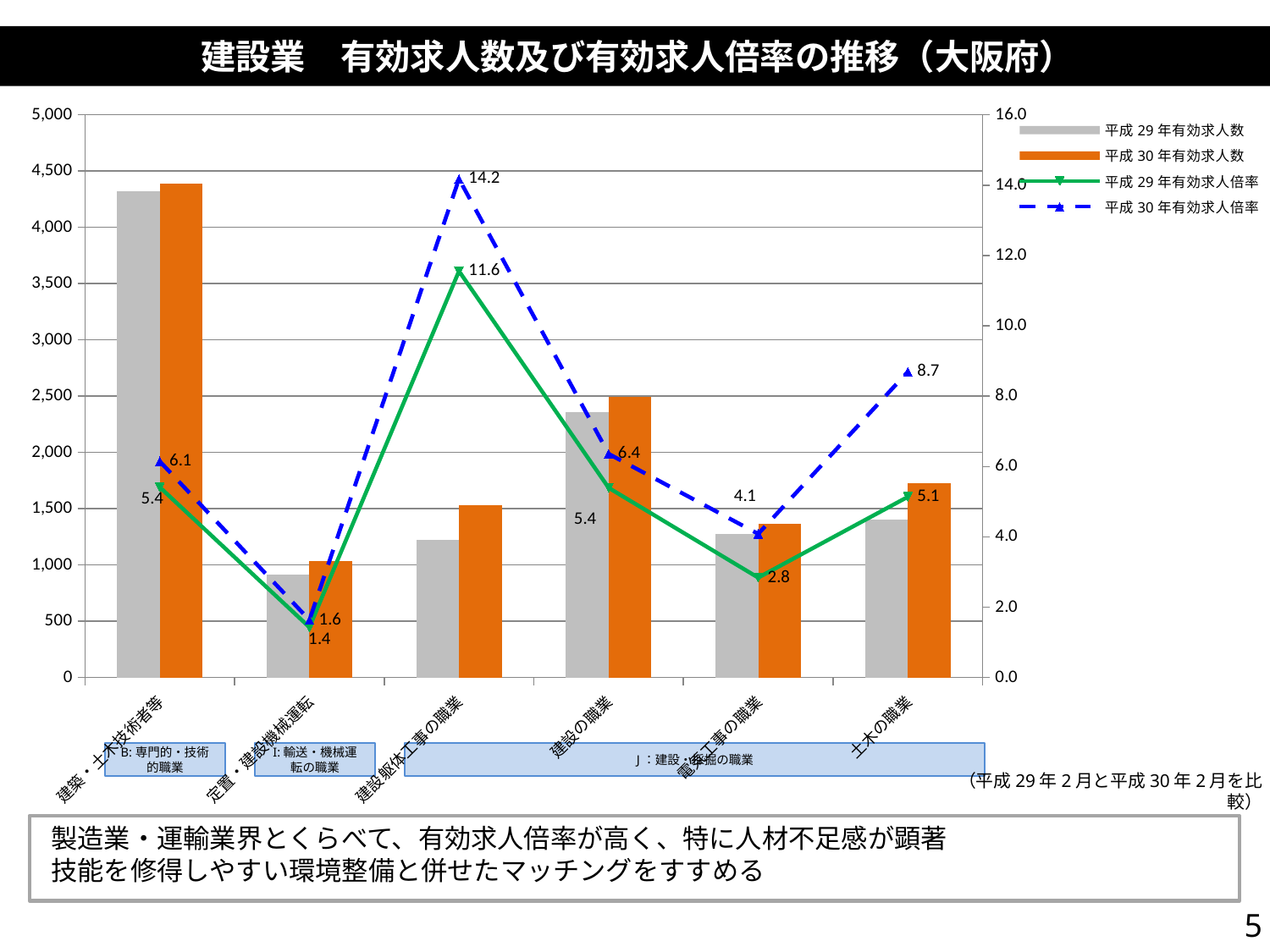
What is the 平成29年有効求人倍率 value for 電気工事の職業? 2.8 By how much did the 有効求人倍率 for 土木の職業 increase from 平成29年 to 平成30年? 3.6 Which category has the lowest 平成29年有効求人倍率? 定置・建設機械運転 How many occupation categories are shown on the x axis? 6 Which has the larger 平成30年有効求人倍率: 建築・土木技術者等 or 建設の職業? 建設の職業 Is the 平成30年有効求人数 bar for 建築・土木技術者等 greater or less than 4,000? greater Which category has the highest 平成30年有効求人倍率? 建設躯体工事の職業 What is the difference between the 平成30年 and 平成29年 有効求人倍率 for 建設躯体工事の職業? 2.6 Is the 平成29年有効求人数 bar for 定置・建設機械運転 greater or less than 1,000? less How many series does the legend list? 4 What kind of chart is shown on the slide? Combined bar and line chart What is the 平成30年有効求人倍率 value for 建設躯体工事の職業? 14.2